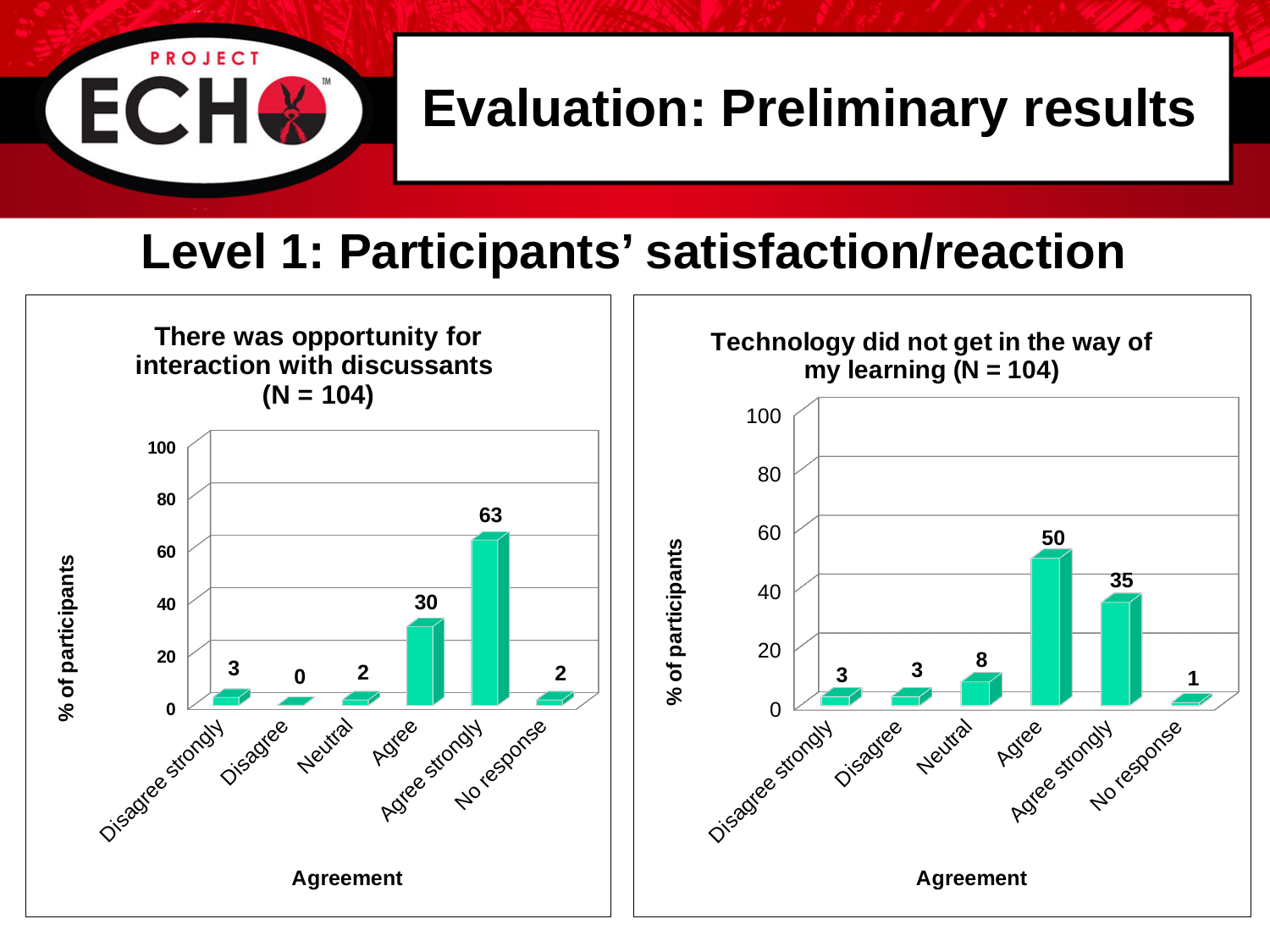
In the left chart ('There was opportunity for interaction with discussants'), what is the value for Agree strongly? 63 In the right chart ('Technology did not get in the way of my learning'), which is larger, Agree or Agree strongly? Agree In the right chart ('Technology did not get in the way of my learning'), what is the value for Agree? 50 In the left chart ('There was opportunity for interaction with discussants'), which category has the lowest value? Disagree In the right chart ('Technology did not get in the way of my learning'), what is the value for Neutral? 8 What kind of chart is the right chart ('Technology did not get in the way of my learning')? Bar chart In the right chart ('Technology did not get in the way of my learning'), what is the difference between Agree and Agree strongly? 15 In the left chart ('There was opportunity for interaction with discussants'), what is the difference between Agree strongly and Agree? 33 How many categories are shown on the x axis of the left chart ('There was opportunity for interaction with discussants')? 6 What is the x-axis title of the left chart ('There was opportunity for interaction with discussants')? Agreement In the right chart ('Technology did not get in the way of my learning'), which category has the highest value? Agree In the left chart ('There was opportunity for interaction with discussants'), what is the value for Agree? 30